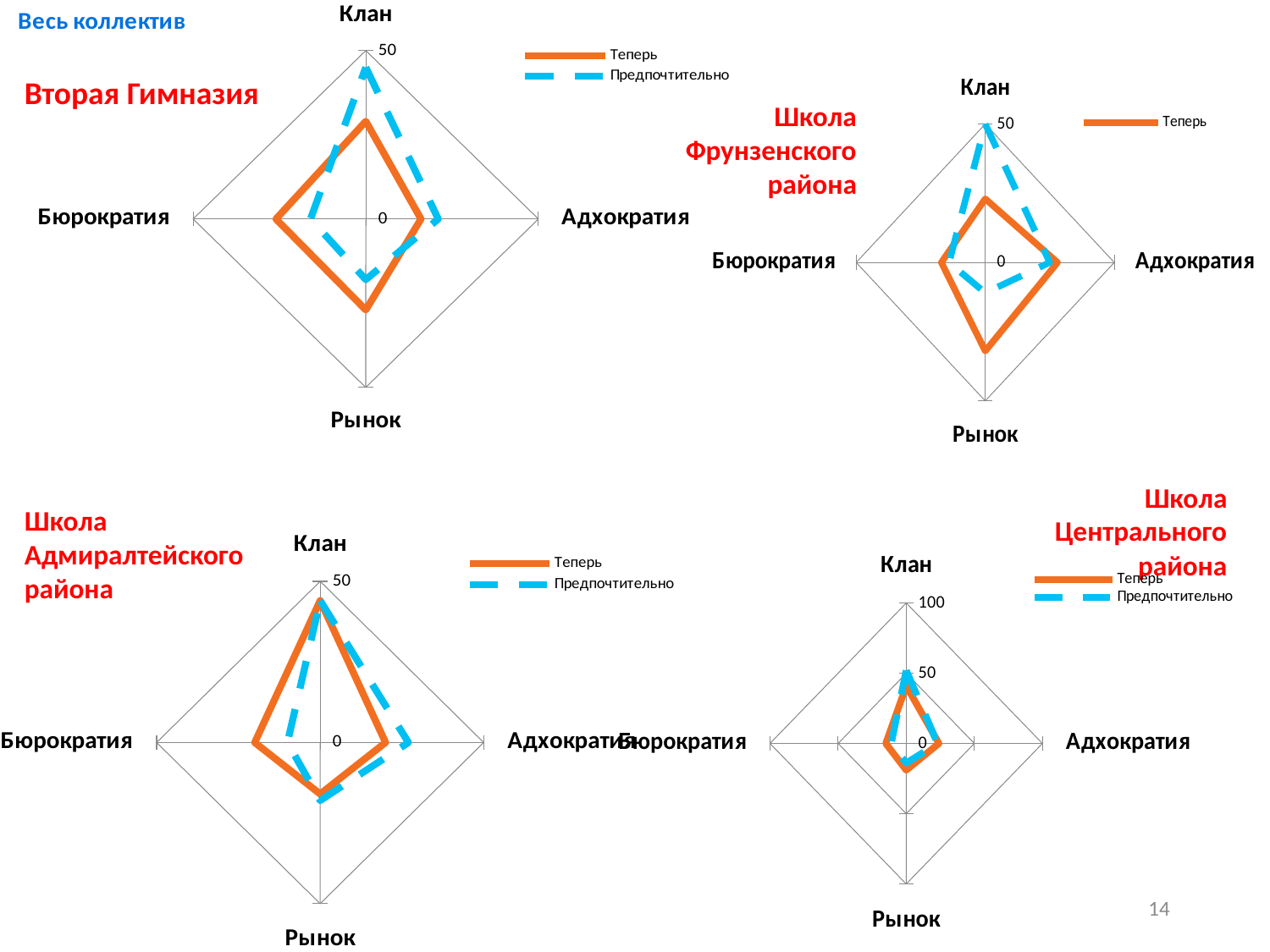
In the "Школа Фрунзенского района" chart, which category has the highest "Теперь" value? Рынок How many categories (axes) does the "Вторая Гимназия" radar chart have? 4 In the "Школа Центрального района" chart, is the "Теперь" value for Клан greater or less than 50? less What is the maximum axis value shown on the "Школа Центрального района" chart? 100 In the "Вторая Гимназия" chart, which category has the highest "Предпочтительно" value? Клан In the "Школа Адмиралтейского района" chart, which series is drawn with a dashed blue line? Предпочтительно How many series does the legend of the "Школа Фрунзенского района" chart list? 1 In the "Вторая Гимназия" chart, is the "Теперь" value for Клан greater or less than 50? less What kind of chart is the "Вторая Гимназия" chart? Radar chart How many series does the legend of the "Вторая Гимназия" chart list? 2 In the "Вторая Гимназия" chart, which is larger for the "Предпочтительно" series: Клан or Рынок? Клан In the "Школа Адмиралтейского района" chart, which is larger for the "Теперь" series: Клан or Адхократия? Клан